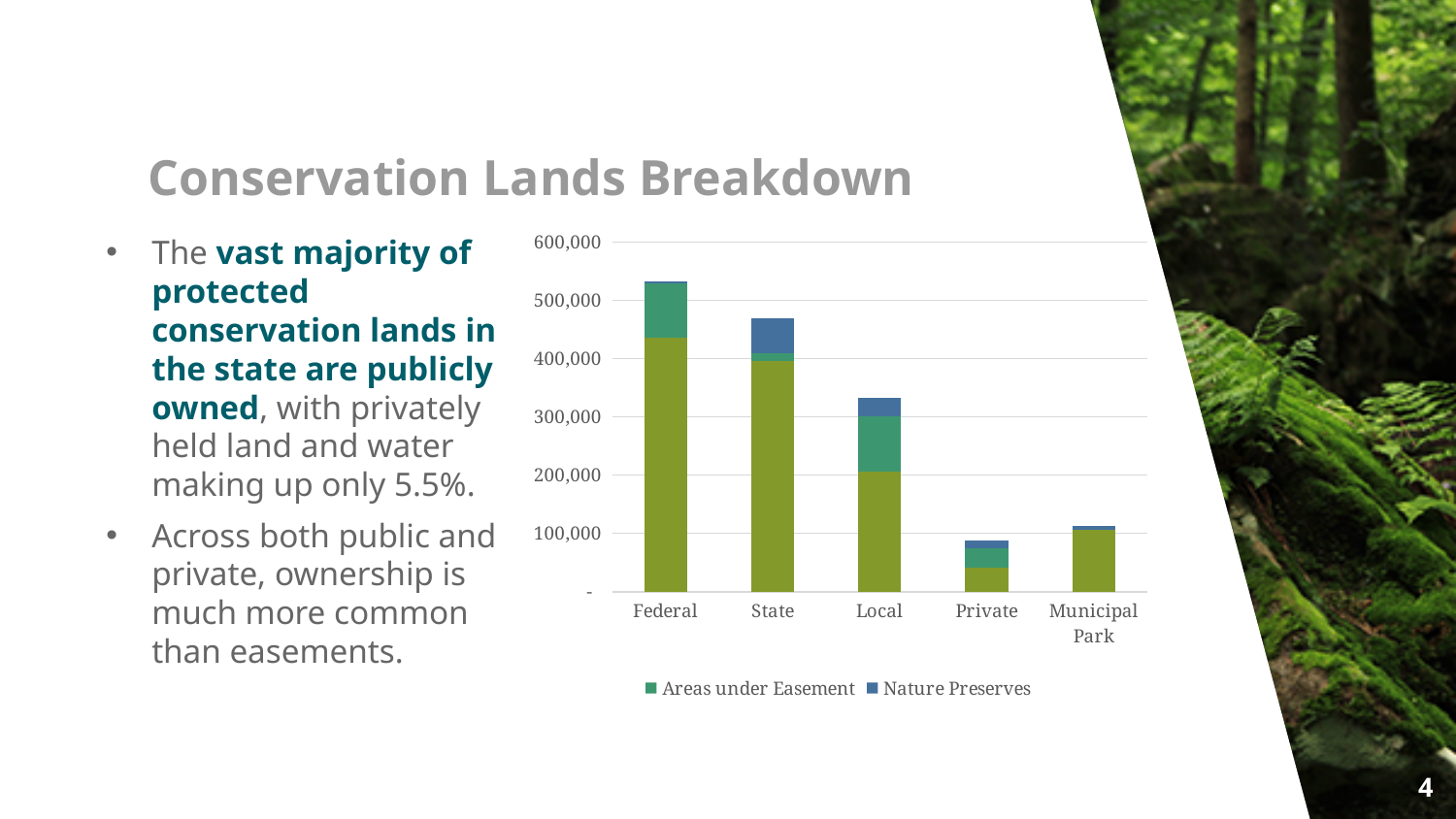
How many entries does the chart's legend list? 2 Which bar is taller, Local or Municipal Park? Local Which bar is taller, Federal or State? Federal What kind of chart is shown on the slide? Stacked bar chart Is the total bar height for Private greater or less than 100,000? less Is the total bar height for State greater or less than 500,000? less Is the total bar height for Local greater or less than 300,000? greater Which category has the tallest bar in the chart? Federal What are the two series named in the chart's legend? Areas under Easement and Nature Preserves Which category has the shortest bar in the chart? Private How many categories are shown on the x axis of the chart? 5